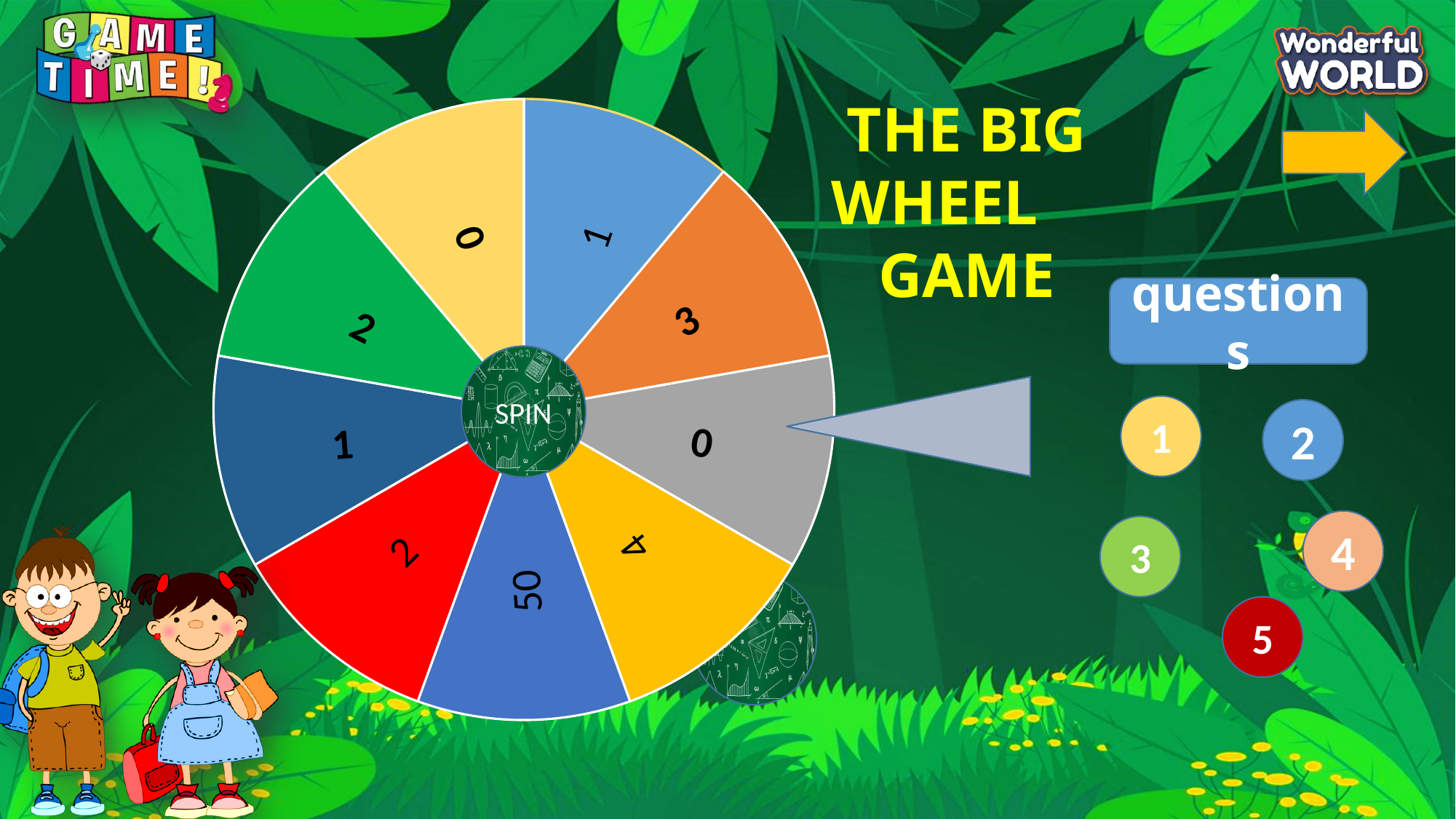
How many segments does the wheel have? 9 What is the title of the game shown next to the wheel? THE BIG WHEEL GAME What number is printed on the grey segment of the wheel? 0 What number is printed on the red segment of the wheel? 2 What number is printed on the orange segment of the wheel? 3 What number is printed on the green segment of the wheel? 2 Which number printed on the wheel is the largest? 50 What number is printed on the gold segment at the lower right of the wheel? 4 What word is written in the centre of the wheel? SPIN What number is printed on the light blue segment at the top right of the wheel? 1 What kind of chart is the wheel on the slide? pie chart